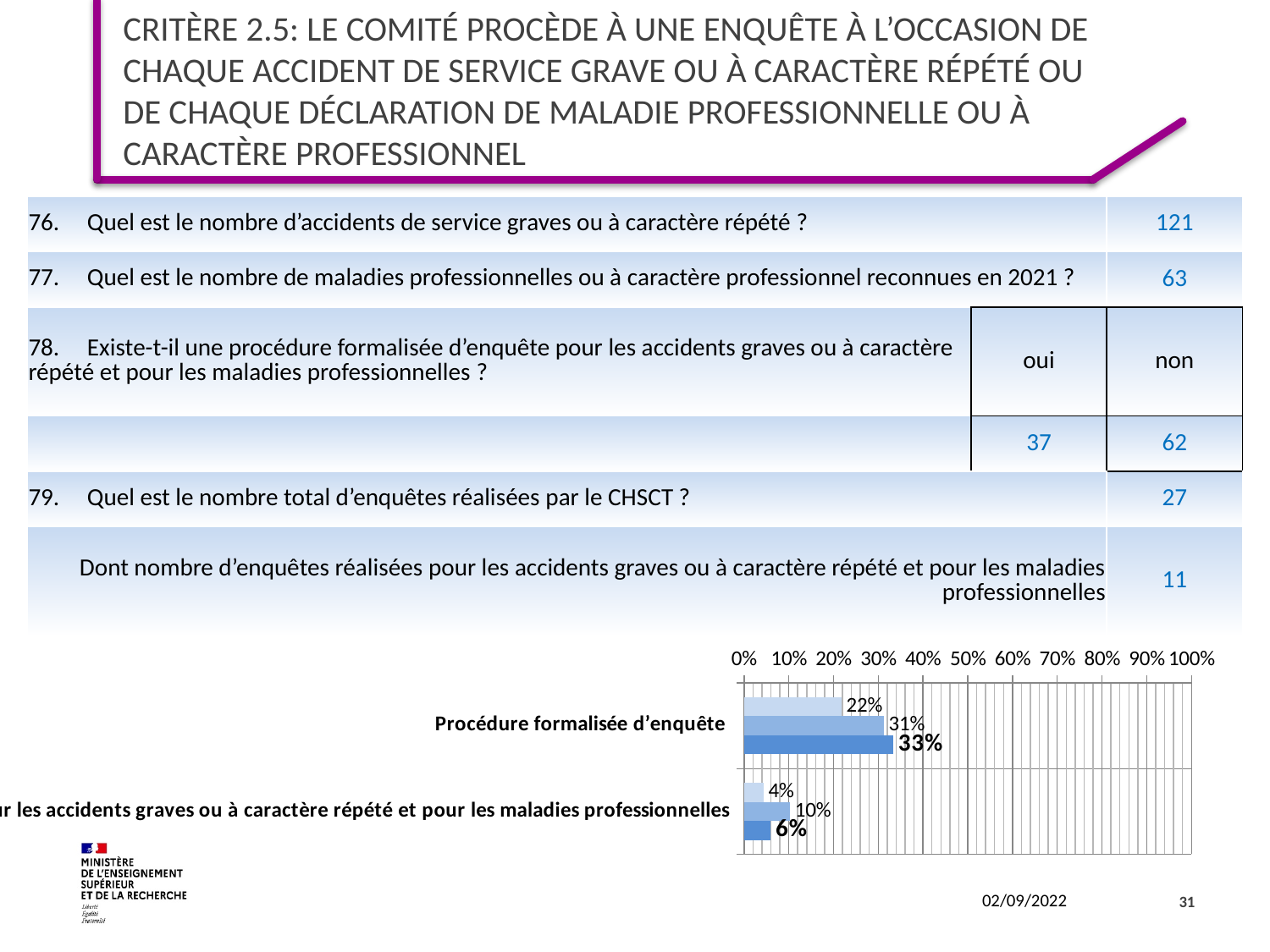
In the bar chart, what is the value of the lightest (top) bar for 'Procédure formalisée d'enquête'? 22% In the bar chart, what is the difference between the darkest bar (33%) and the lightest bar (22%) for 'Procédure formalisée d'enquête'? 11 percentage points In the bar chart, which category has the larger value for the darkest (bottom) bar? Procédure formalisée d'enquête In the bar chart, what is the value of the middle bar for 'Procédure formalisée d'enquête'? 31% In the bar chart, what is the value of the lightest (top) bar for the second (lower) category? 4% In the bar chart, what is the value of the darkest (bottom) bar for 'Procédure formalisée d'enquête'? 33% In the bar chart, what is the value of the middle bar for the second (lower) category? 10% What kind of chart is shown at the bottom of the slide? bar chart In the bar chart, is the darkest bar for 'Procédure formalisée d'enquête' greater or less than 50%? less In the bar chart, what is the value of the darkest (bottom) bar for the second (lower) category? 6% How many categories are plotted in the bar chart? 2 How many bars are plotted for each category in the bar chart? 3